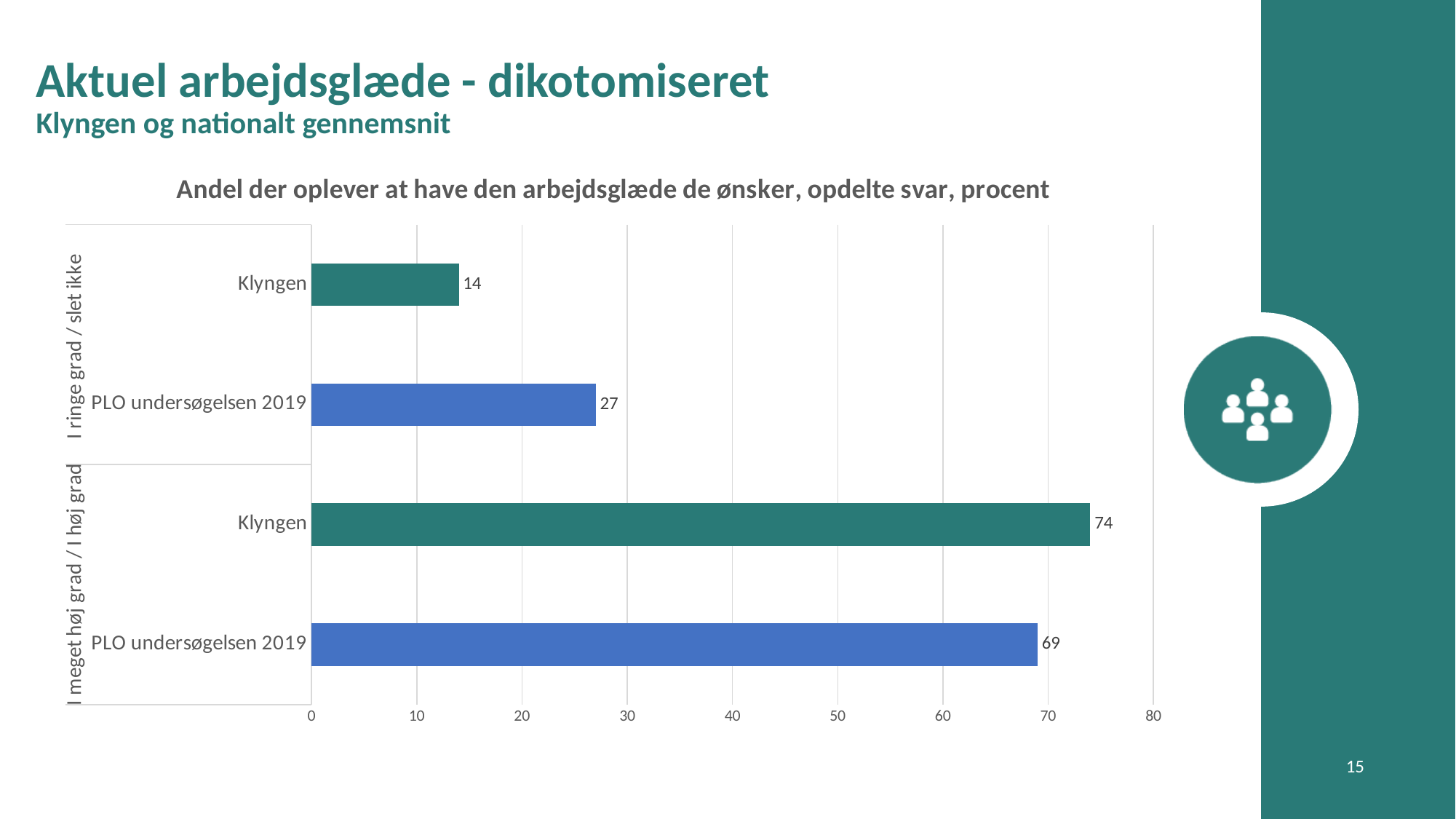
What is the value for PLO undersøgelsen 2019 in the 'I meget høj grad / I høj grad' group? 69 What is the difference between Klyngen and PLO undersøgelsen 2019 in the 'I meget høj grad / I høj grad' group? 5 In the 'I ringe grad / slet ikke' group, which is larger: Klyngen or PLO undersøgelsen 2019? PLO undersøgelsen 2019 What type of chart is shown on the slide? Bar chart Which bar has the lowest value in the chart? Klyngen (I ringe grad / slet ikke) Is the value for Klyngen in the 'I meget høj grad / I høj grad' group greater or less than 70? greater Which bar has the highest value in the chart? Klyngen (I meget høj grad / I høj grad) What is the value for PLO undersøgelsen 2019 in the 'I ringe grad / slet ikke' group? 27 What is the difference between PLO undersøgelsen 2019 and Klyngen in the 'I ringe grad / slet ikke' group? 13 How many bars are plotted in the chart? 4 What is the value for Klyngen in the 'I ringe grad / slet ikke' group? 14 What is the value for Klyngen in the 'I meget høj grad / I høj grad' group? 74